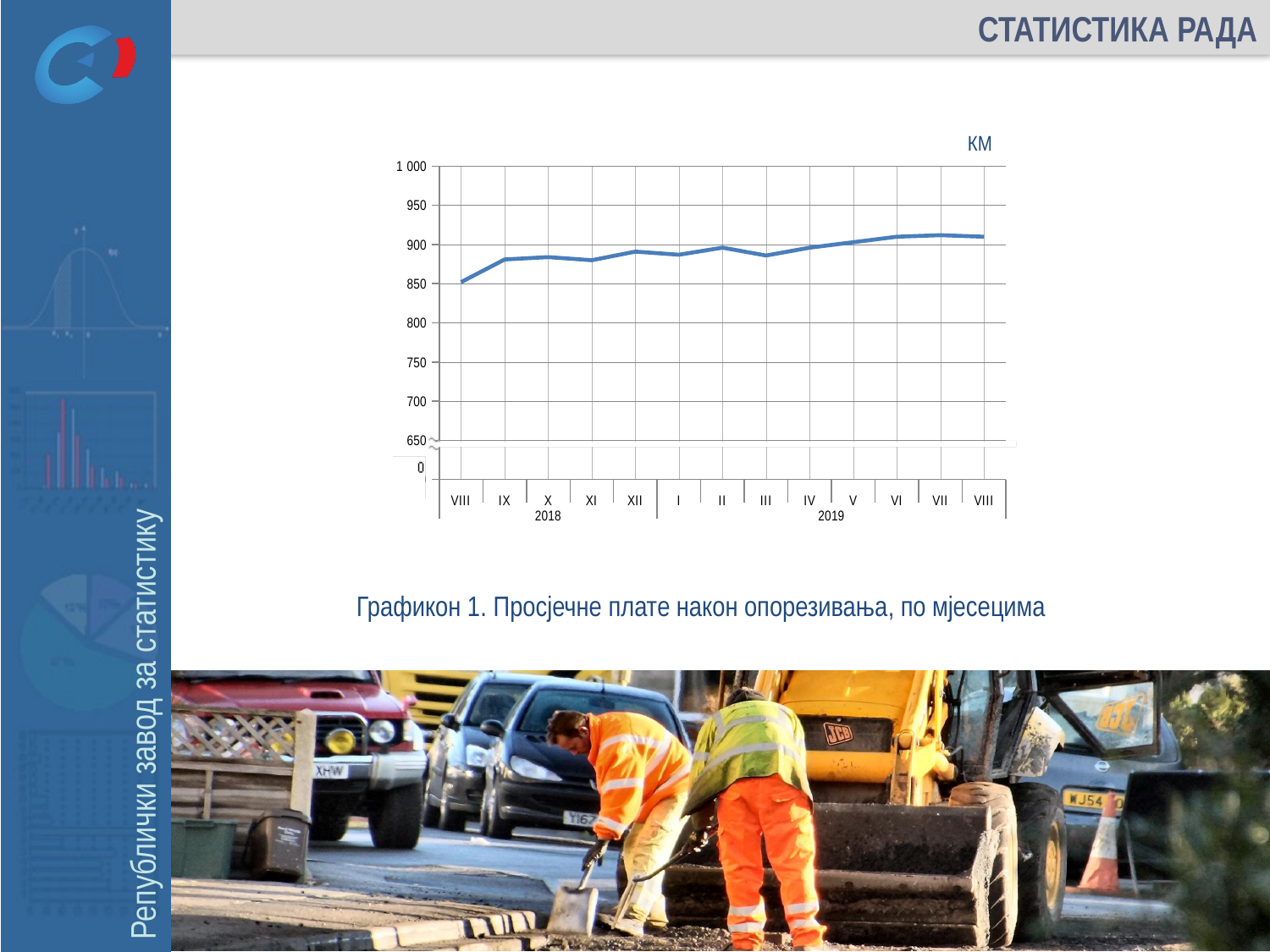
What kind of chart is shown on the slide? line chart What is the title of the chart? Графикон 1. Просјечне плате након опорезивања, по мјесецима Is the value for VIII 2018 greater or less than 900? less Is the value for VI 2019 greater or less than 950? less Is the value for VII 2019 greater or less than 900? greater Which is larger, the value for IX 2018 or the value for VI 2019? VI 2019 What unit is shown at the top right of the chart? KM Which month has the lowest value on the chart? VIII 2018 How many monthly data points are plotted on the chart? 13 Do the values generally rise or fall from VIII 2018 to VIII 2019? rise Which is larger, the value for VIII 2018 or the value for VIII 2019? VIII 2019